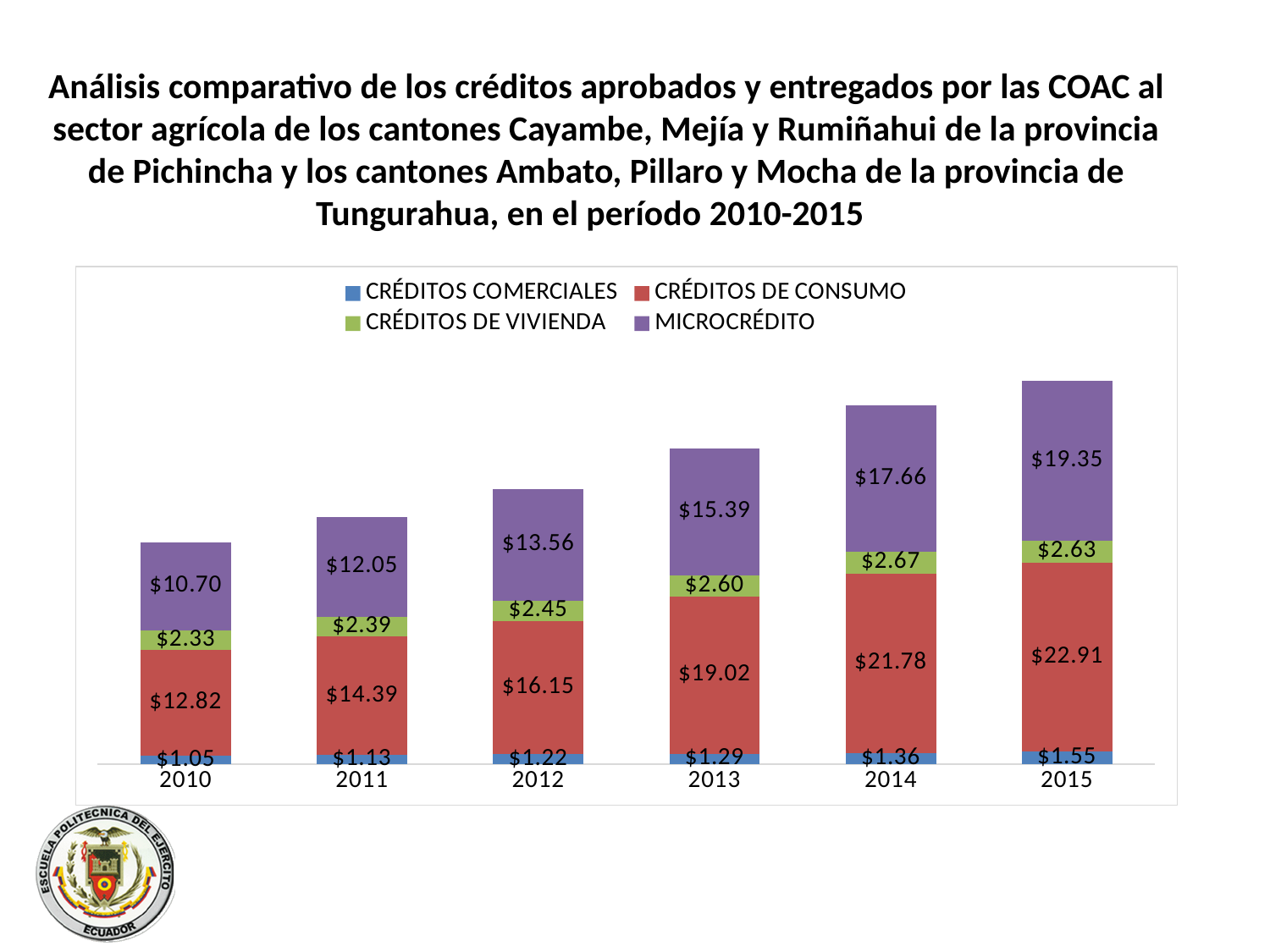
What is the difference between CRÉDITOS DE CONSUMO in 2015 and in 2010? $10.09 What is the total of the stacked bar for 2010? $26.90 In which year is CRÉDITOS DE CONSUMO lowest? 2010 What kind of chart is shown on the slide? Stacked bar chart What is the value of CRÉDITOS COMERCIALES in 2015? $1.55 Which is larger in 2012: CRÉDITOS DE CONSUMO or MICROCRÉDITO? CRÉDITOS DE CONSUMO How many years are shown on the x axis? 6 What is the value of MICROCRÉDITO in 2011? $12.05 In which year is MICROCRÉDITO highest? 2015 What is the value of CRÉDITOS DE CONSUMO in 2013? $19.02 How many series does the legend list? 4 What is the value of CRÉDITOS DE VIVIENDA in 2014? $2.67